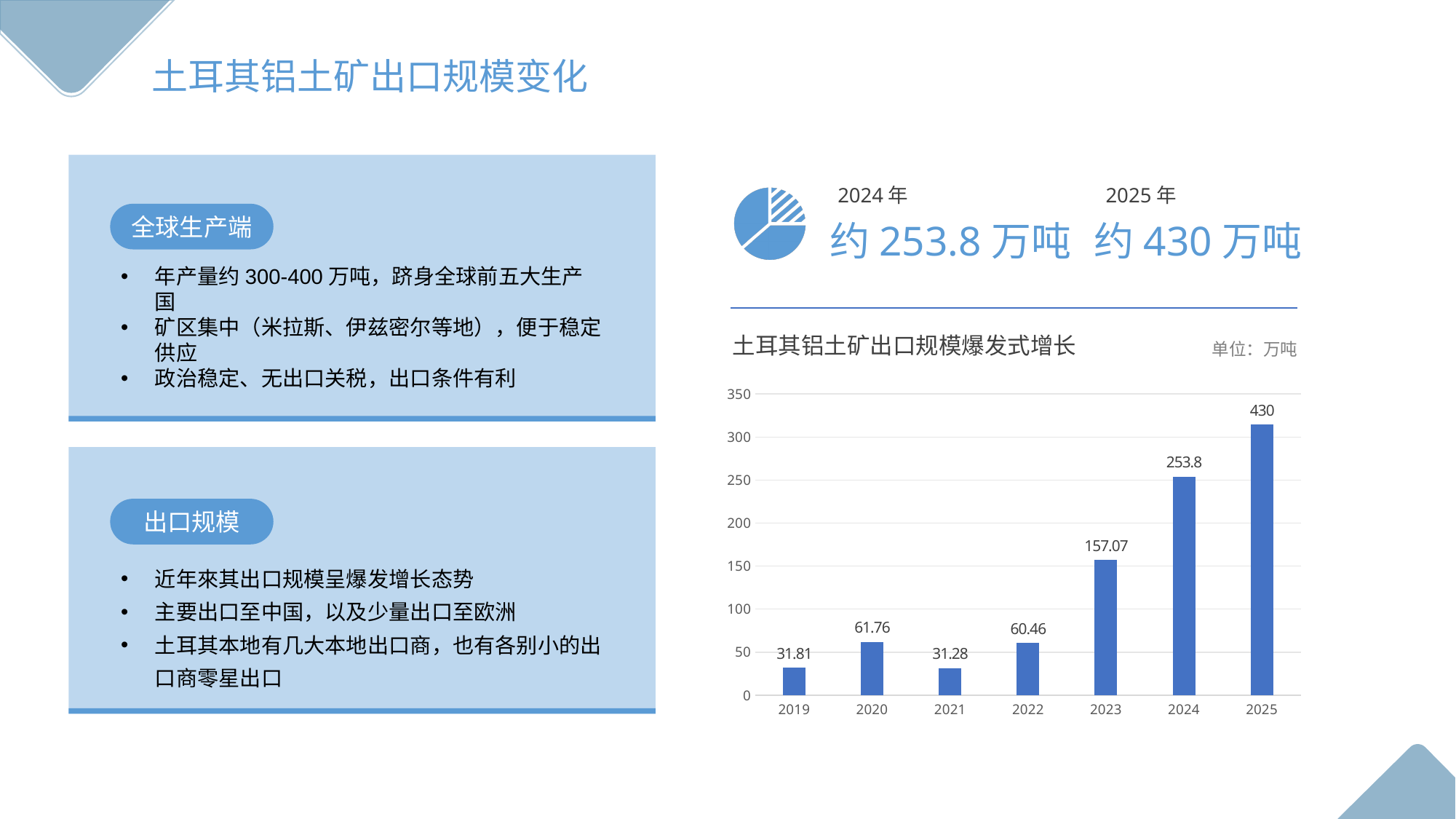
How many years are shown on the x axis of the chart? 7 Which year has the lowest value in the chart? 2021 Is the value for 2023 greater or less than 150? greater Which is larger, the value for 2020 or the value for 2022? 2020 What unit is stated for the chart values? 万吨 What kind of chart is shown on the slide? bar chart Which year has the highest value in the chart? 2025 What is the difference between the values for 2024 and 2023? 96.73 What is the value for 2020 in the chart? 61.76 What is the value for 2023 in the chart? 157.07 What is the value for 2019 in the chart? 31.81 What is the difference between the values for 2025 and 2024? 176.2